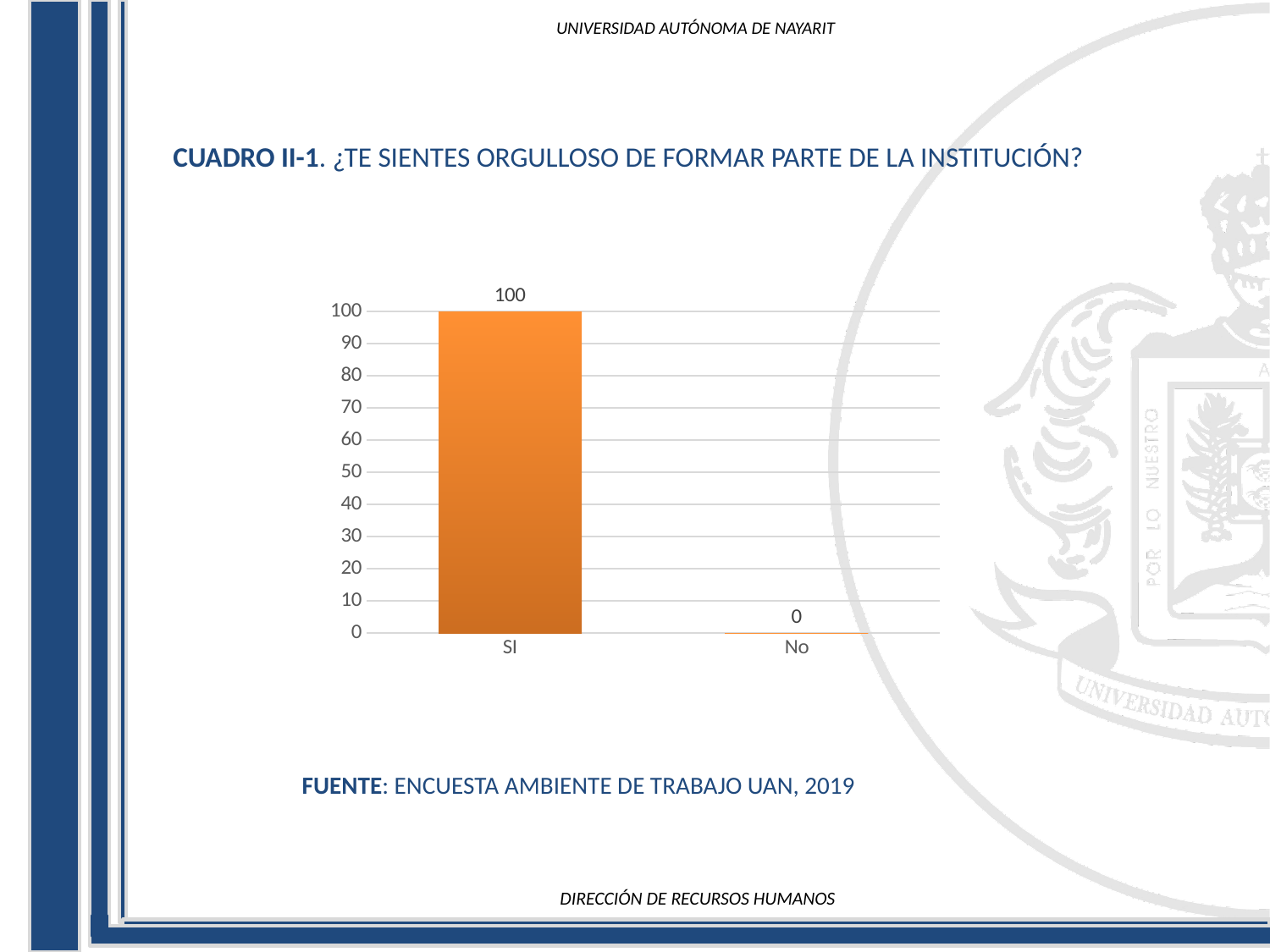
How many categories are shown on the x axis? 2 Which is larger, the value for SI or the value for No? SI What is the highest value shown on the y axis? 100 Which category has the highest value? SI Which category has the lowest value? No What kind of chart is shown on the slide? bar chart What is the value for No? 0 Do the values rise or fall from SI to No? fall What is the difference between the values for SI and No? 100 Is the value for SI greater or less than 50? greater What is the value for SI? 100 What source is cited below the chart? ENCUESTA AMBIENTE DE TRABAJO UAN, 2019